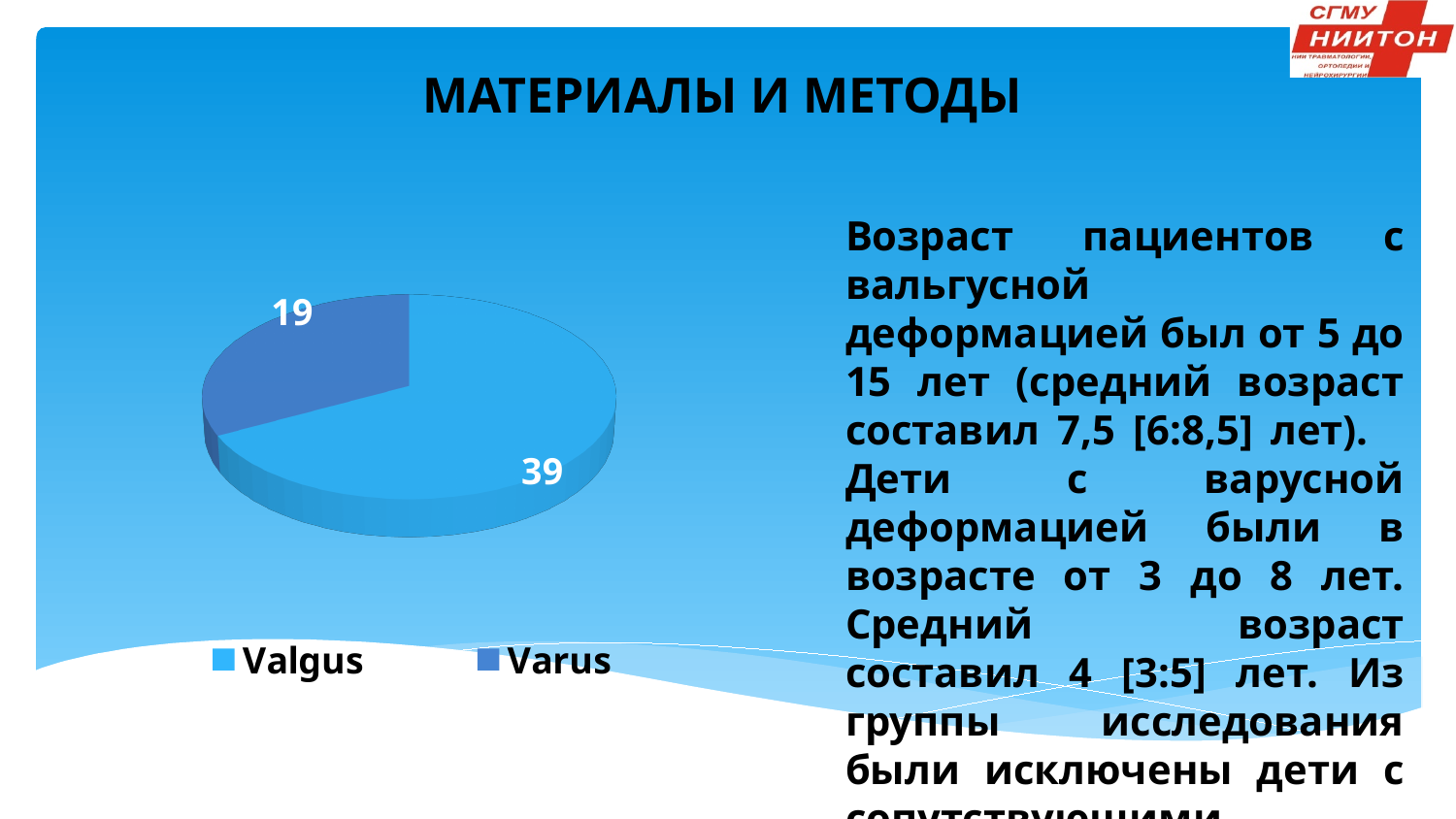
What is the value for Varus in the pie chart? 19 How many entries does the legend list? 2 What kind of chart is shown on the slide? Pie chart Which legend entry is shown in the darker blue colour? Varus Which is larger, the value for Valgus or the value for Varus? Valgus What is the value for Valgus in the pie chart? 39 What is the difference between the Valgus and Varus values? 20 Which category has the smallest slice in the pie chart? Varus Which category has the largest slice in the pie chart? Valgus What is the total of all slices in the pie chart? 58 How many slices does the pie chart have? 2